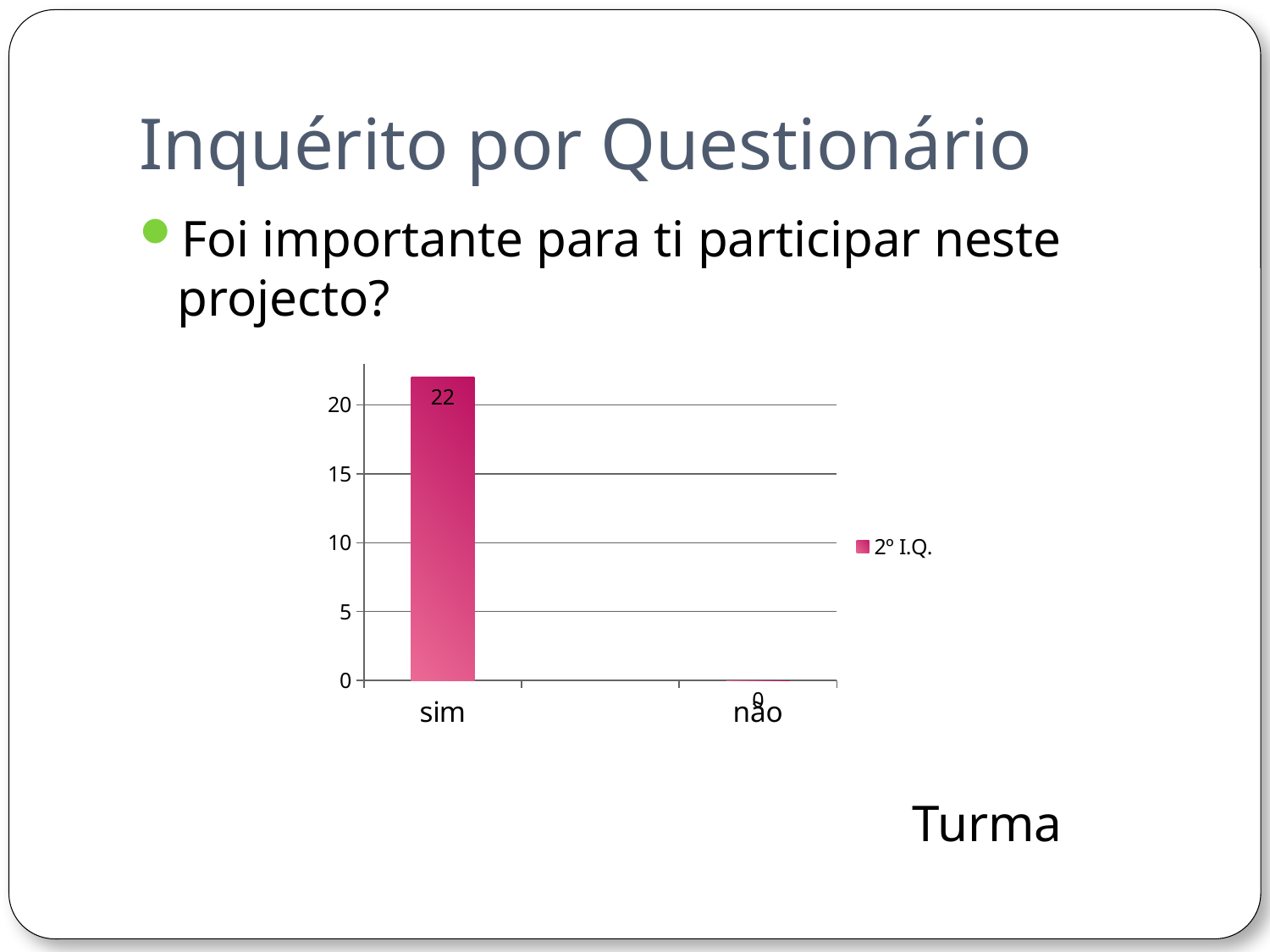
Which category has the highest value? sim What is the difference between the values for "sim" and "não"? 22 How many series does the legend list? 1 Is the value for "sim" greater or less than 20? greater What is the value for "sim"? 22 What is the value for "não"? 0 Which category has the lowest value? não What kind of chart is shown? bar chart What is the highest tick value shown on the y axis? 20 How many categories are shown on the x axis? 2 What is the name of the series in the legend? 2º I.Q. Which is larger, the value for "sim" or the value for "não"? sim